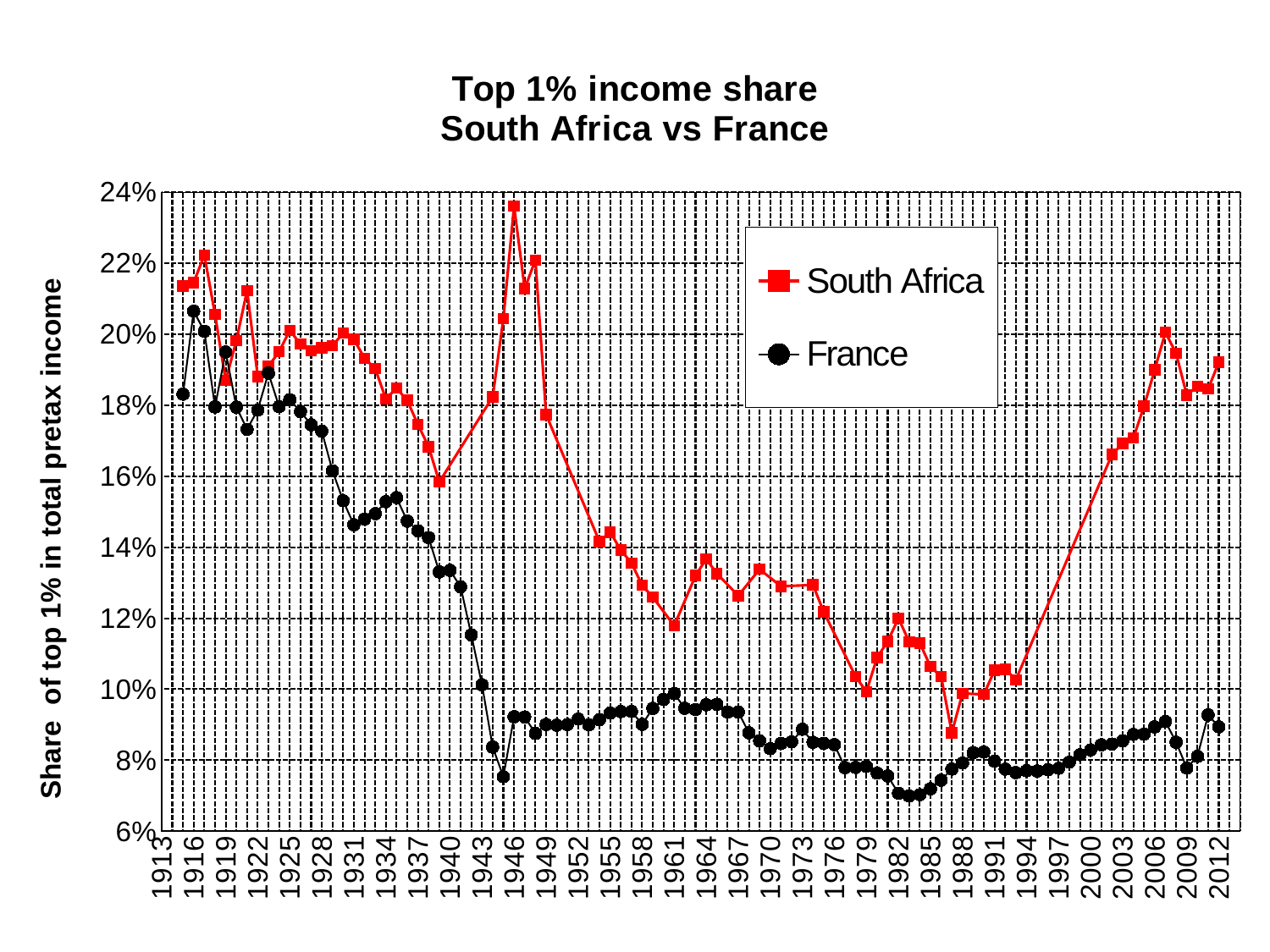
Does the France series rise or fall between 1925 and 1943? Fall Is the value for France in 1982 greater or less than 8%? less What is the title of the chart? Top 1% income share South Africa vs France Is the value for South Africa in 2006 greater or less than 18%? greater What kind of chart is shown on the slide? Line chart Which series is drawn with red square markers? South Africa Does the South Africa series rise or fall between 1994 and 2006? Rise How many series does the legend list? 2 Is the value for South Africa in 1946 greater or less than 22%? greater In 1982, which series has the higher value, South Africa or France? South Africa